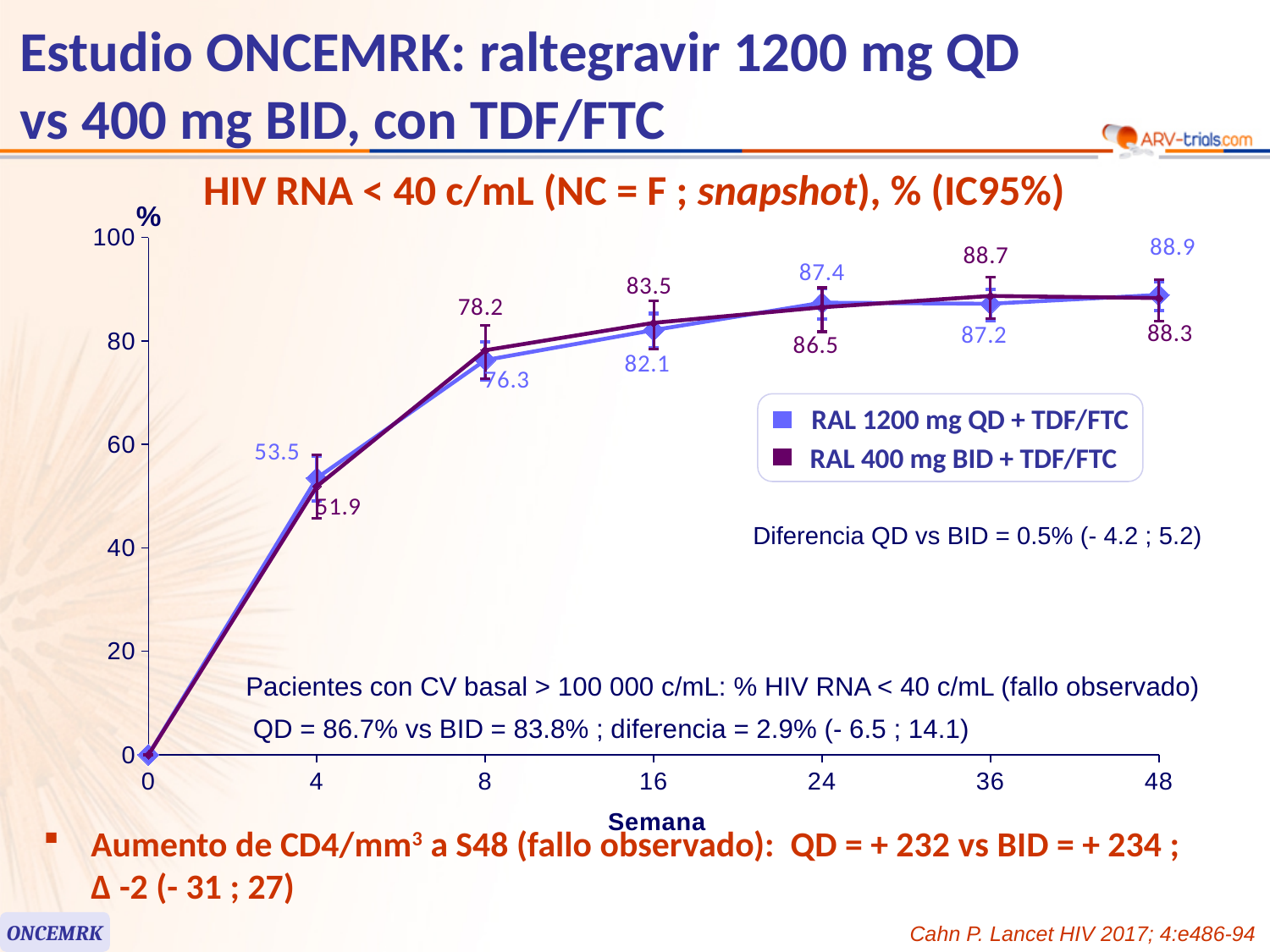
What kind of chart is shown on the slide? line chart What is the label of the x axis? Semana What is the value for RAL 1200 mg QD + TDF/FTC at week 4? 53.5 What is the difference between the RAL 1200 mg QD and RAL 400 mg BID values at week 4? 1.6 What is the value for RAL 400 mg BID + TDF/FTC at week 36? 88.7 What is the value for RAL 400 mg BID + TDF/FTC at week 8? 78.2 At week 16, which series has the higher value, RAL 1200 mg QD or RAL 400 mg BID? RAL 400 mg BID + TDF/FTC Do the values for RAL 400 mg BID + TDF/FTC rise or fall from week 0 to week 36? rise How many series does the legend list? 2 How many time points are shown on the x axis? 7 At which week does the RAL 1200 mg QD + TDF/FTC series reach its highest value? 48 What is the value for RAL 1200 mg QD + TDF/FTC at week 48? 88.9